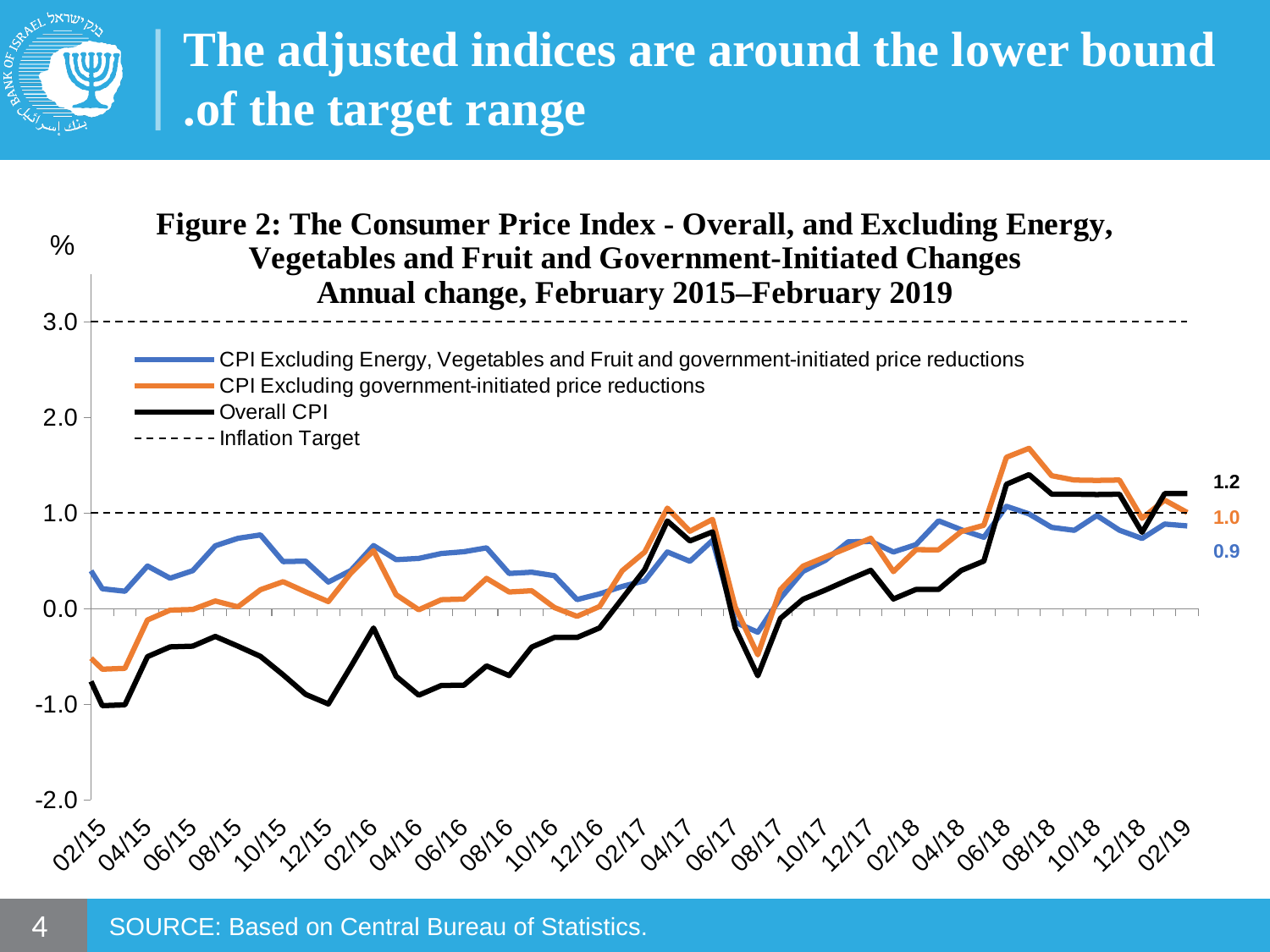
Is the CPI Excluding government-initiated price reductions value at 08/18 greater or less than 1.0? greater What is the value of the CPI Excluding Energy, Vegetables and Fruit and government-initiated price reductions series at 02/19? 0.9 What kind of chart is shown on the slide? line chart At 02/19, what is the difference between the Overall CPI value and the CPI Excluding Energy, Vegetables and Fruit and government-initiated price reductions value? 0.3 How many entries does the legend list? 4 At 02/19, which series has the highest value? Overall CPI At 02/19, which is larger: the Overall CPI value or the CPI Excluding government-initiated price reductions value? Overall CPI What is the value of the CPI Excluding government-initiated price reductions series at 02/19? 1.0 What is the value of the Overall CPI series at 02/19? 1.2 Does the Overall CPI series rise or fall overall from 02/15 to 02/19? rise Is the Overall CPI value at 02/15 greater or less than 0.0? less At 02/15, which series has the lowest value? Overall CPI